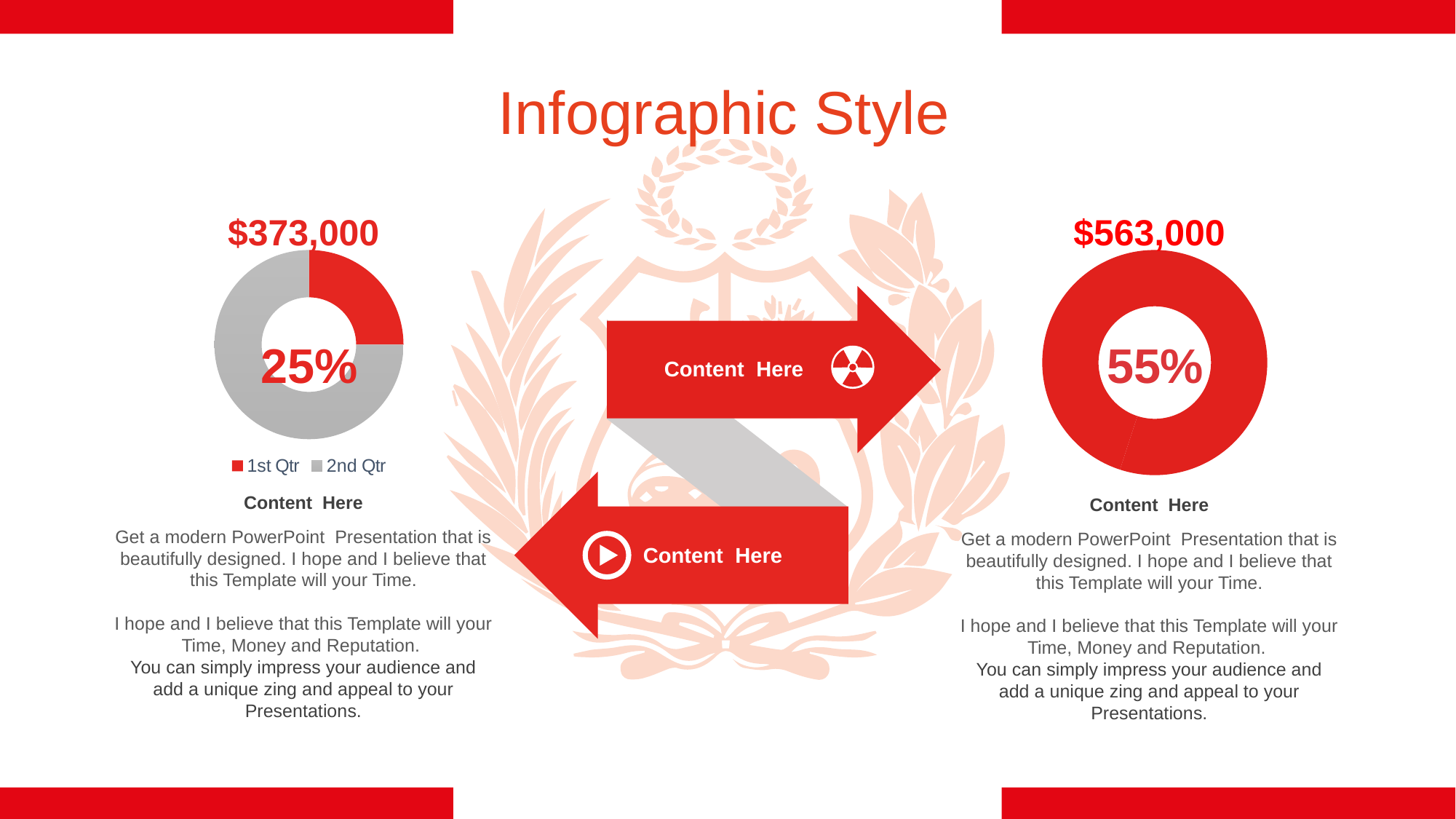
Which chart has the larger dollar value printed above it, the left chart or the right chart? The right chart ($563,000) On the left chart, which legend entry is shown in red? 1st Qtr On the left chart, which slice is larger, 1st Qtr or 2nd Qtr? 2nd Qtr What dollar value is printed above the left chart? $373,000 What kind of chart is the left chart labelled $373,000? Doughnut chart What is the difference between the dollar values printed above the right chart and the left chart? $190,000 On the left chart, what share of the doughnut does the 1st Qtr slice represent? 25% What dollar value is printed above the right chart? $563,000 On the left chart, what percentage is shown in the centre of the doughnut? 25% What kind of chart is the right chart labelled $563,000? Doughnut chart On the right chart, what percentage is shown in the centre of the doughnut? 55% How many entries does the legend of the left chart list? 2